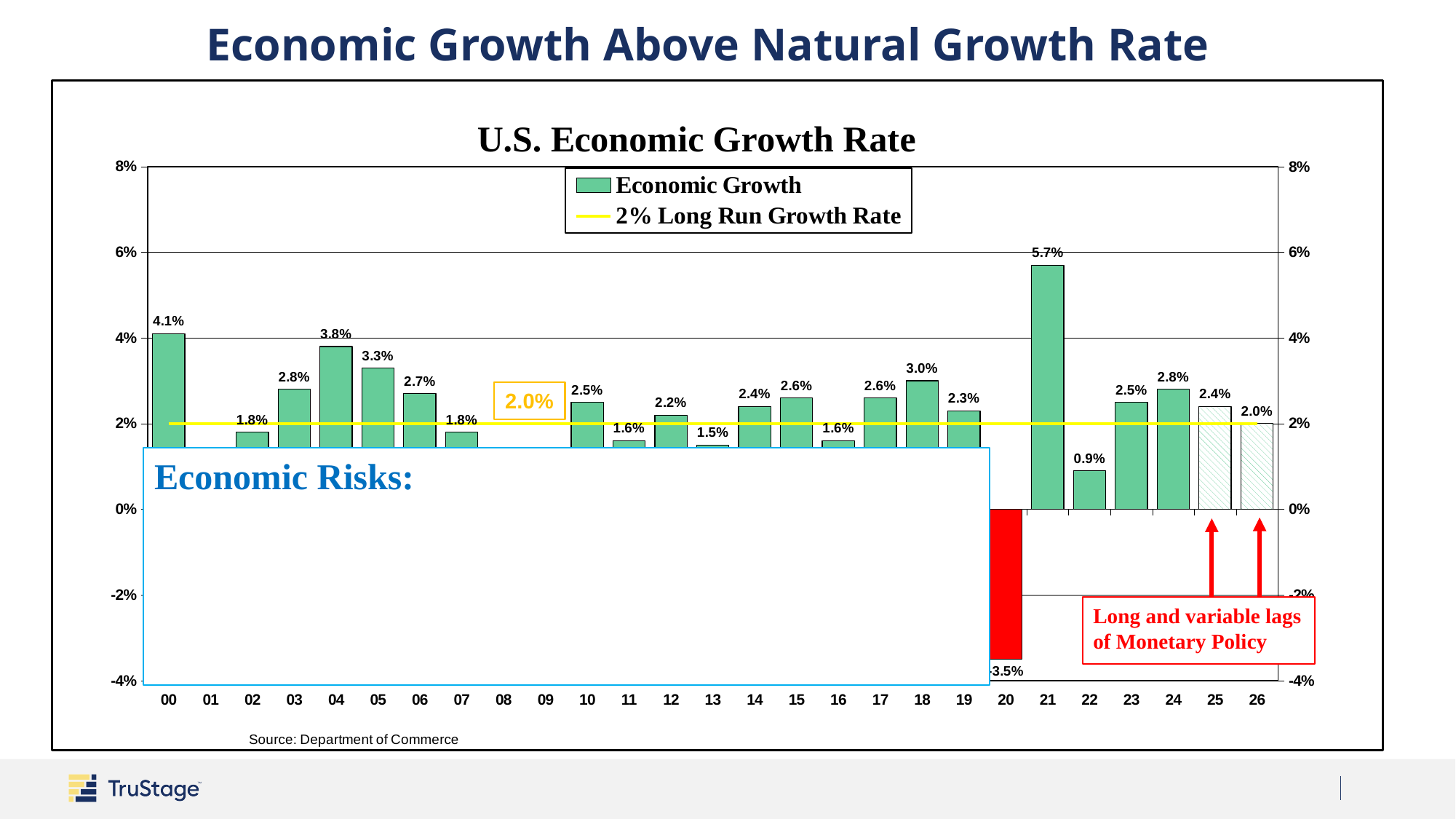
What is the economic growth rate shown for 04? 3.8% Which year has the highest economic growth rate on the chart? 21 Which year has the lowest economic growth rate on the chart? 20 What is the difference between the growth rates for 21 and 22? 4.8 percentage points Is the growth rate for 21 greater or less than 4%? greater What is the economic growth rate shown for 20? -3.5% What kind of chart is used to show the economic growth rate? Bar chart What is the economic growth rate shown for 21? 5.7% How many series does the legend list? 2 Which year has the higher growth rate, 18 or 19? 18 How many years are shown on the x axis of the chart? 27 What is the economic growth rate shown for 26? 2.0%